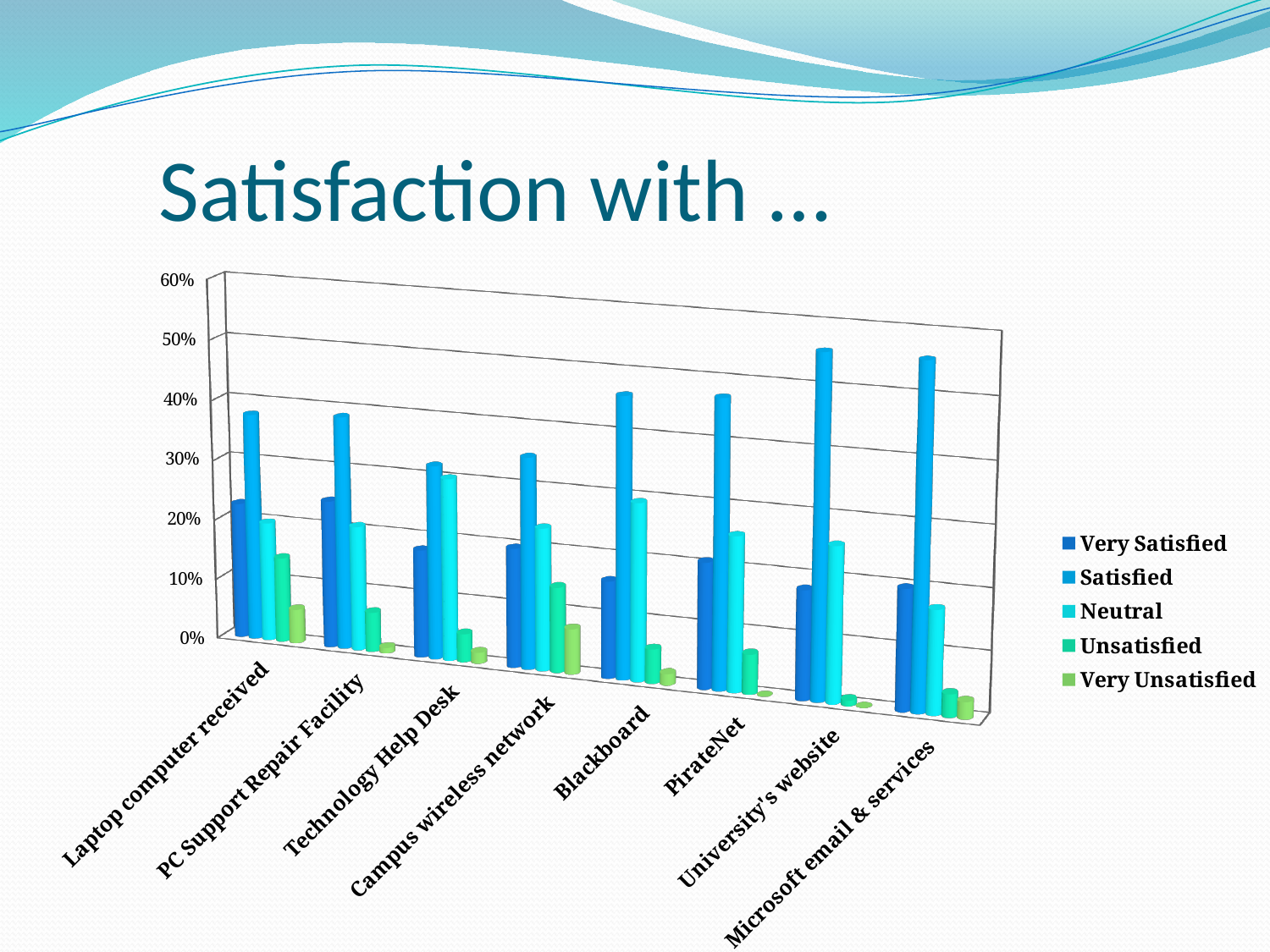
Is the Very Unsatisfied value for PirateNet greater or less than 10%? less Which series is listed last in the chart's legend? Very Unsatisfied How many series does the chart's legend list? 5 What is the title of the chart on the slide? Satisfaction with ... Is the Satisfied value for Microsoft email & services greater or less than 40%? greater Is the Satisfied value for University's website greater or less than 40%? greater Which is larger: the Satisfied value for University's website or the Satisfied value for Campus wireless network? University's website How many categories are shown along the x axis of the chart? 8 What kind of chart is shown on the slide? bar chart